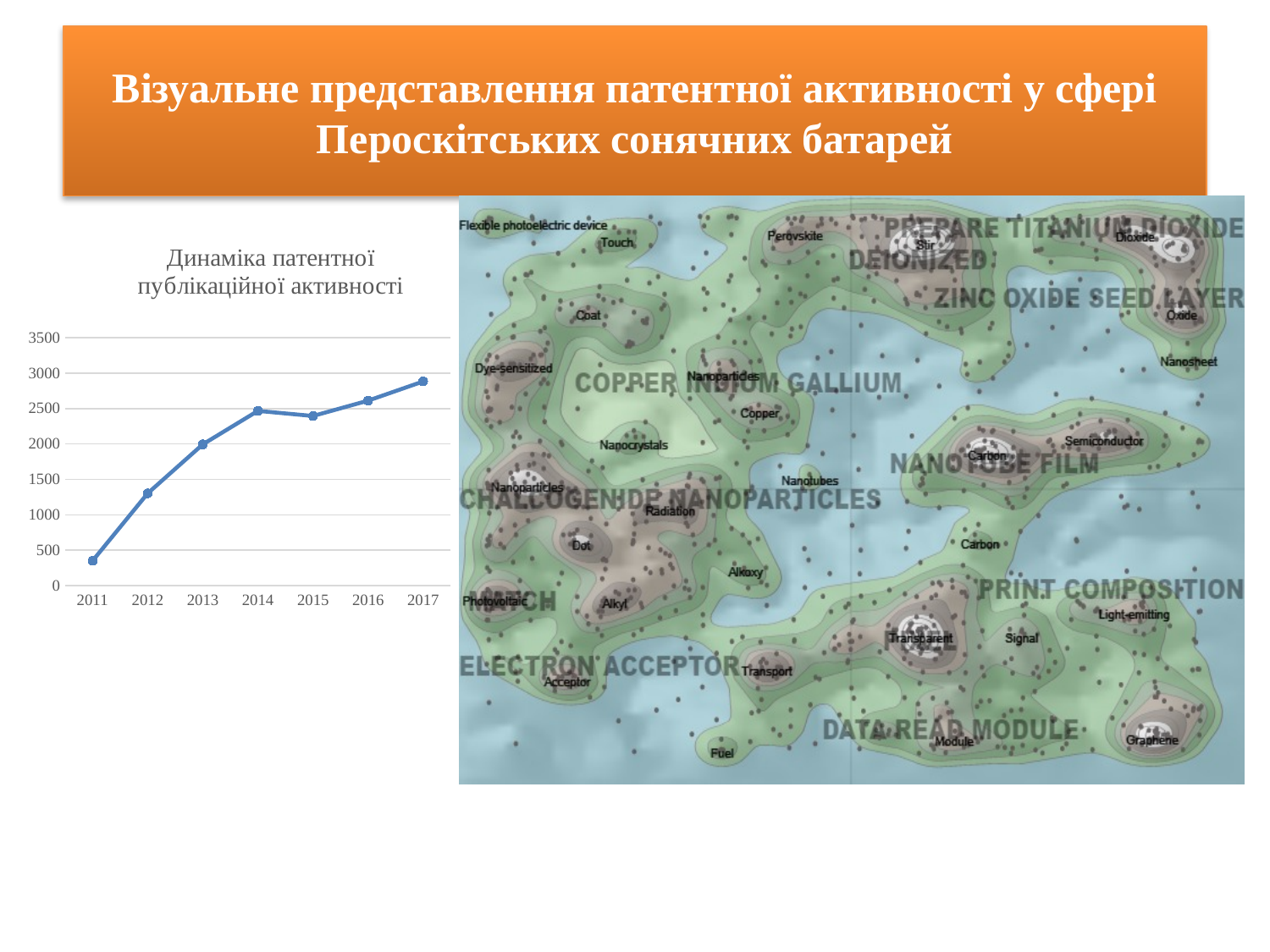
In the chart "Динаміка патентної публікаційної активності", is the value for 2016 greater or less than 3000? less What kind of chart is the chart titled "Динаміка патентної публікаційної активності"? line chart In the chart "Динаміка патентної публікаційної активності", which year has the larger value, 2013 or 2016? 2016 In the chart "Динаміка патентної публікаційної активності", which year has the larger value, 2012 or 2014? 2014 In the chart "Динаміка патентної публікаційної активності", is the value for 2012 greater or less than 1000? greater How many years are shown on the x axis of the chart "Динаміка патентної публікаційної активності"? 7 In the chart "Динаміка патентної публікаційної активності", is the value for 2017 greater or less than 2500? greater In the chart "Динаміка патентної публікаційної активності", which year has the lowest value? 2011 In the chart "Динаміка патентної публікаційної активності", which year has the highest value? 2017 What is the first year shown on the x axis of the chart "Динаміка патентної публікаційної активності"? 2011 In the chart "Динаміка патентної публікаційної активності", do the values generally rise or fall from 2011 to 2017? rise